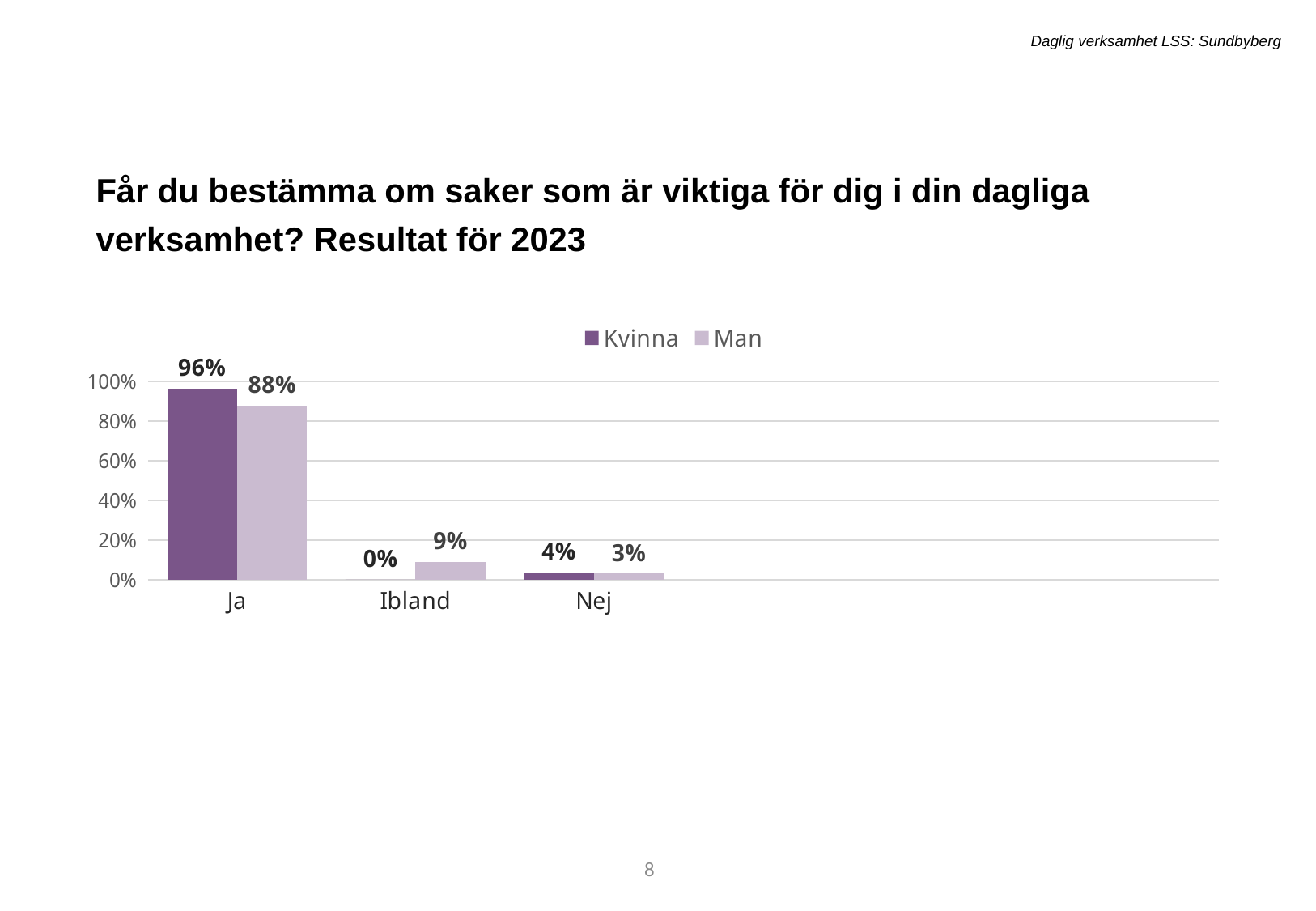
What is the value for Kvinna in the Ibland category? 0% Which category has the lowest value for the Kvinna series? Ibland What is the value for Man in the Ibland category? 9% What is the difference between the Kvinna and Man values in the Ja category? 8% What kind of chart is shown on the slide? Bar chart Which category has the highest value for the Man series? Ja How many series does the legend list? 2 In the Ibland category, which series has the larger value, Kvinna or Man? Man What is the value for Kvinna in the Nej category? 4% What is the value for Kvinna in the Ja category? 96% What is the value for Man in the Ja category? 88% How many categories are shown on the x axis? 3